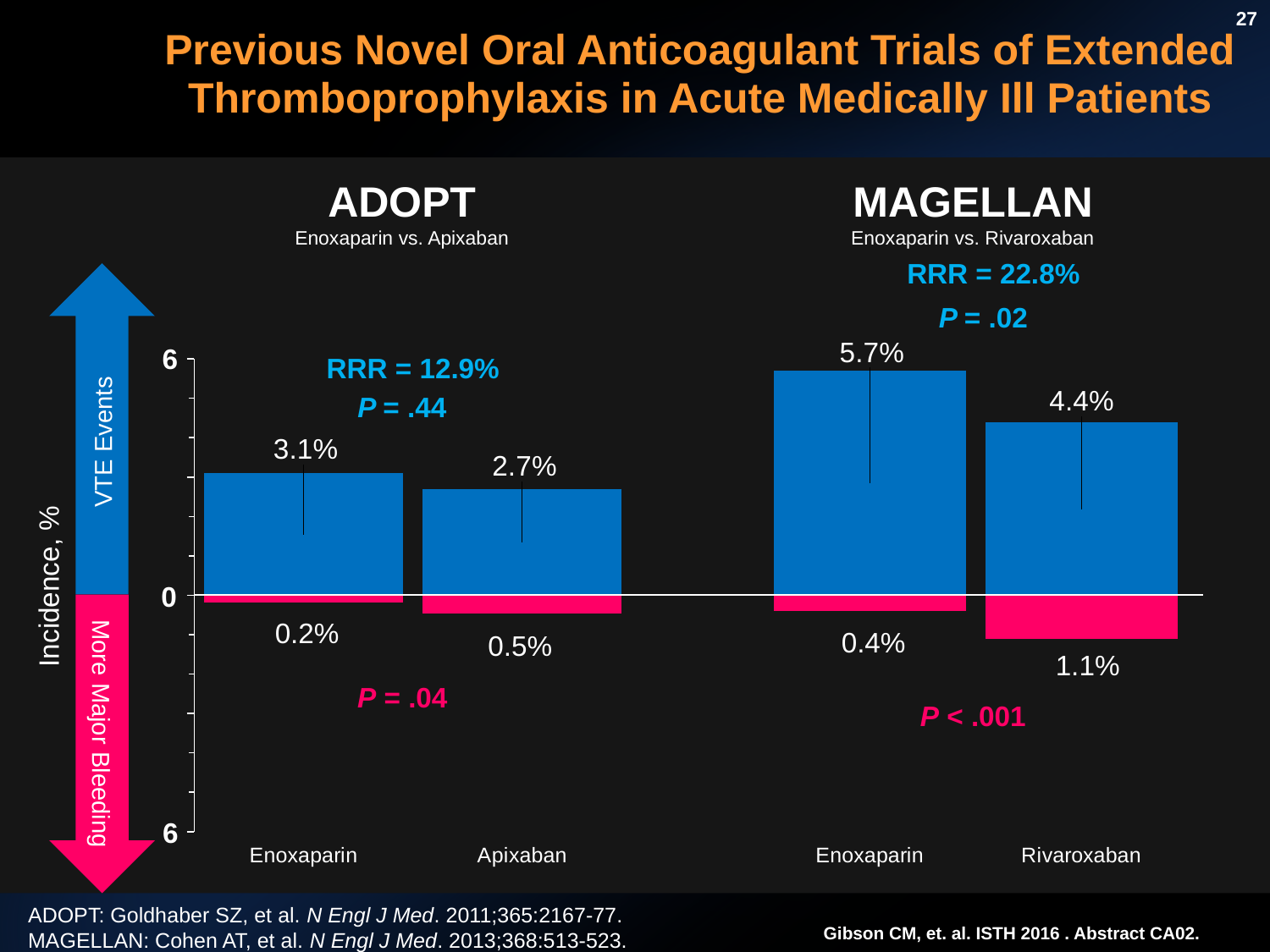
Across both trials, which treatment arm has the highest VTE event rate? Enoxaparin (MAGELLAN) In the ADOPT trial, what is the VTE event rate for Apixaban? 2.7% How many treatment arms (bars) are shown in the chart in total? 4 What is the RRR reported for the MAGELLAN trial? 22.8% In the MAGELLAN trial, what is the difference in VTE event rate between Enoxaparin and Rivaroxaban? 1.3% Across both trials, which treatment arm has the lowest major bleeding rate? Enoxaparin (ADOPT) In the MAGELLAN trial, what is the VTE event rate for Rivaroxaban? 4.4% In the MAGELLAN trial, which arm has the higher major bleeding rate, Enoxaparin or Rivaroxaban? Rivaroxaban In the MAGELLAN trial, what is the major bleeding rate for Enoxaparin? 0.4% In the ADOPT trial, what is the VTE event rate for Enoxaparin? 3.1% What type of chart is shown on the slide? Bar chart In the ADOPT trial, what is the major bleeding rate for Apixaban? 0.5%